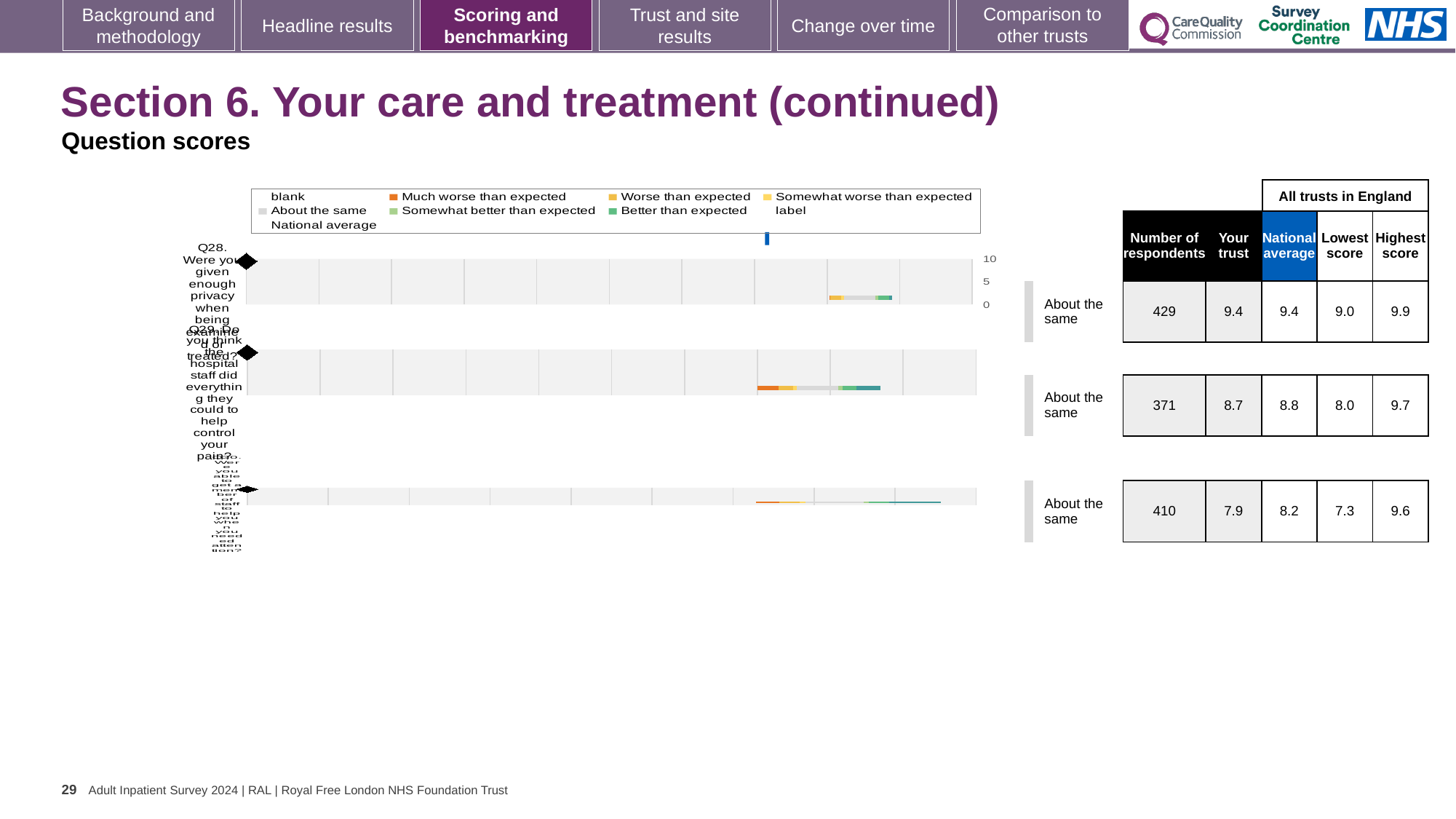
How many respondents answered Q30? 410 Which question has the highest 'Your trust' score? Q28 What kind of chart is used to show the question scores on this slide? bar chart Which question has the lowest 'Your trust' score? Q30 What benchmark category is shown for Q28? About the same What is the national average score for Q29 (staff did everything to help control your pain)? 8.8 For Q30, what is the difference between the highest score and the lowest score across all trusts in England? 2.3 What is the highest score among all trusts in England for Q28? 9.9 For Q30, how much higher is the national average than the 'Your trust' score? 0.3 What is the 'Your trust' score for Q28 (privacy when being examined or treated)? 9.4 How many questions are plotted on this slide? 3 For Q29, which is larger: the 'Your trust' score or the national average? National average